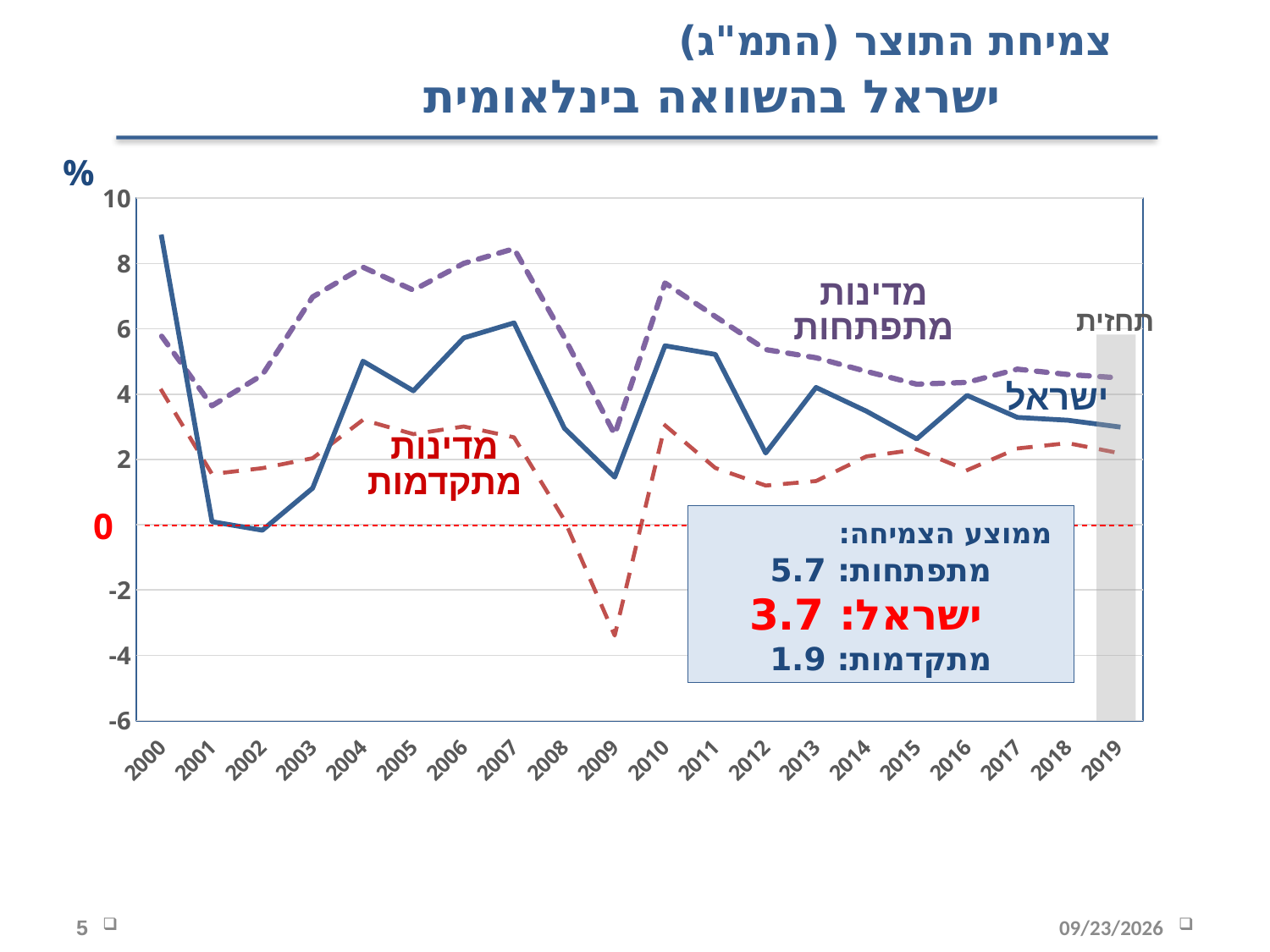
Which group has the highest average growth listed in the box on the chart? מתפתחות Which year on the x axis is marked as a forecast (תחזית) with a grey shaded band? 2019 What type of chart is shown on the slide? line chart How many years are shown on the x axis of the chart? 20 Is the value for ישראל in 2000 greater or less than 8? greater According to the box on the chart, what is the average growth for מתקדמות (advanced countries)? 1.9 According to the box on the chart, what is the average growth for מתפתחות (developing countries)? 5.7 In 2009, which line is higher: ישראל or מדינות מתקדמות? ישראל What is the difference between the average growth of מתפתחות and ישראל shown in the box? 2.0 According to the box on the chart, what is the average growth (ממוצע הצמיחה) for ישראל? 3.7 Is the value for מדינות מתקדמות in 2009 greater or less than -2? less How many lines (series) are plotted on the chart? 3